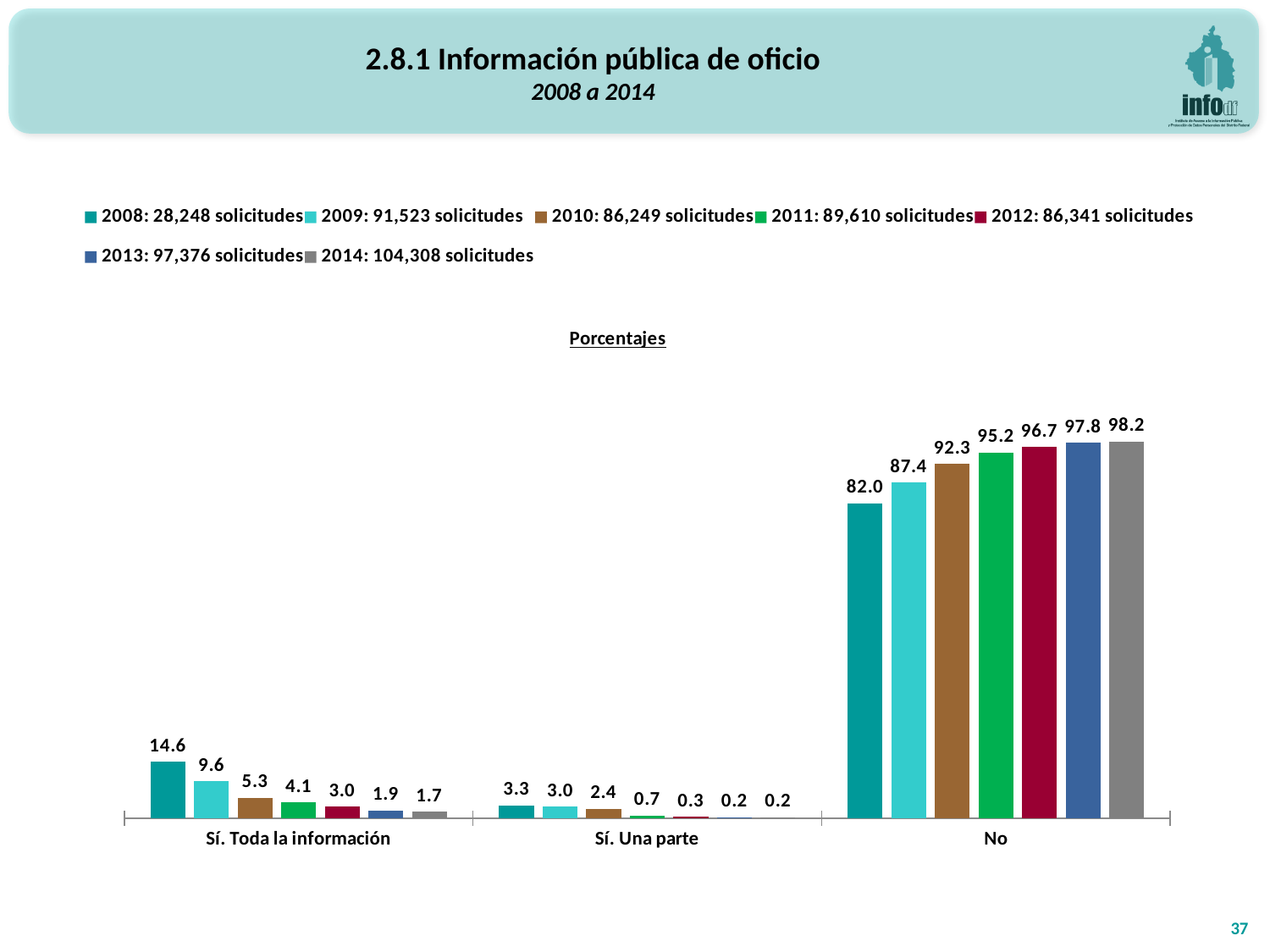
How many categories are shown on the x axis? 3 What is the difference between the 2014 and 2008 values in the 'No' category? 16.2 What is the value for 2014 in the 'No' category? 98.2 What kind of chart is shown on the slide? Bar chart According to the legend, how many solicitudes were there in 2014? 104,308 Which is larger: the 2009 value for 'Sí. Toda la información' or the 2009 value for 'Sí. Una parte'? Sí. Toda la información How many series does the legend list? 7 What is the value for 2008 in the 'Sí. Toda la información' category? 14.6 Which year has the lowest value in the 'Sí. Toda la información' category? 2014 Which year has the highest value in the 'No' category? 2014 Do the values in the 'No' category rise or fall from 2008 to 2014? Rise What is the value for 2010 in the 'Sí. Una parte' category? 2.4